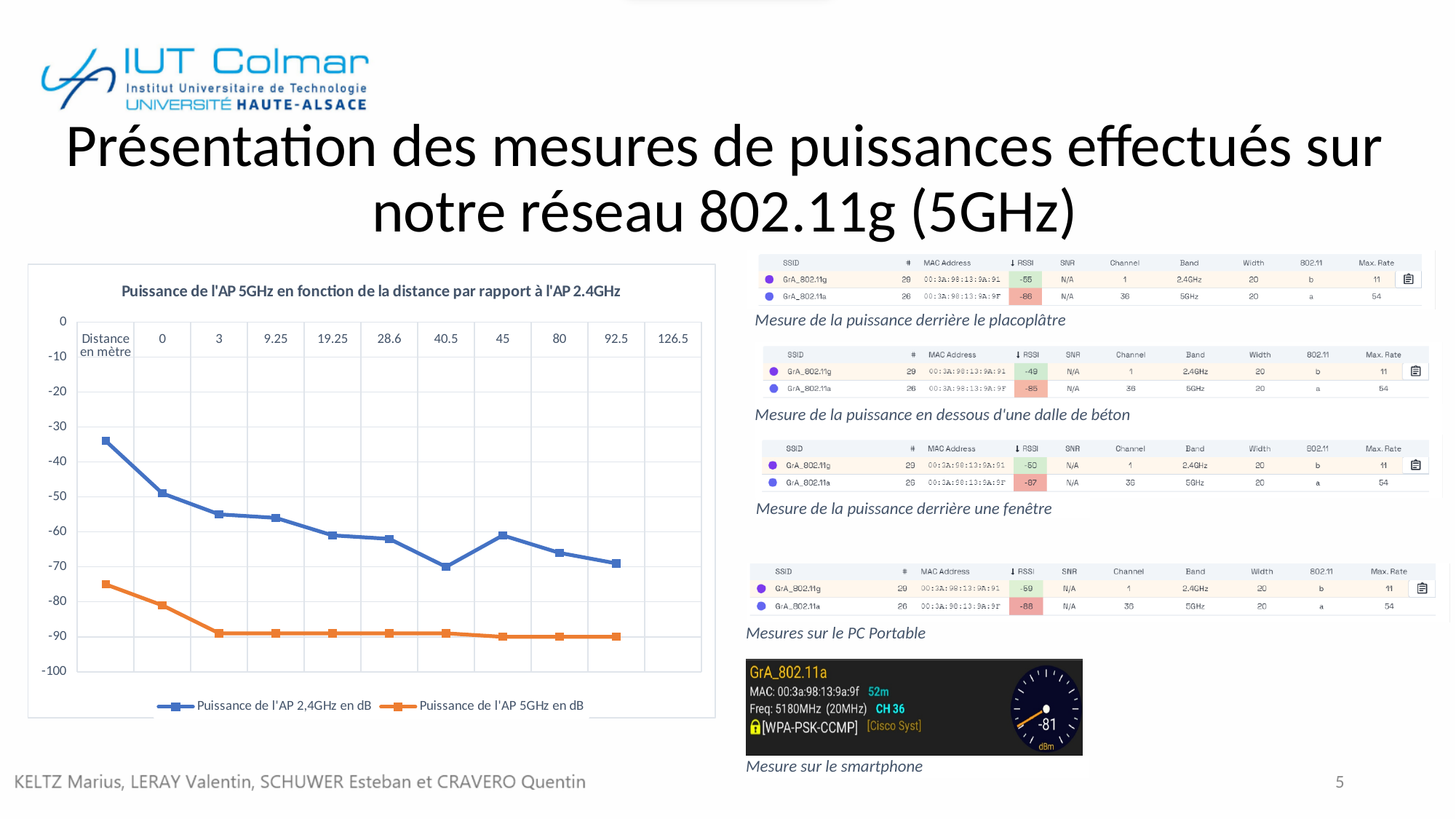
How many data points does each series in the chart have? 10 Is the leftmost value of the 'Puissance de l'AP 2,4GHz en dB' series greater or less than -40? greater What kind of chart is shown on the left of the slide? line chart How many series does the legend of the chart list? 2 Is the leftmost value of the 'Puissance de l'AP 5GHz en dB' series greater or less than -70? less Does the 'Puissance de l'AP 2,4GHz en dB' series generally rise or fall from left to right along the x axis? fall Which series reaches the lowest value on the chart? Puissance de l'AP 5GHz en dB What is the title of the chart? Puissance de l'AP 5GHz en fonction de la distance par rapport à l'AP 2.4GHz Which colour is used for the series 'Puissance de l'AP 5GHz en dB'? orange Is the rightmost value of the 'Puissance de l'AP 5GHz en dB' series greater or less than -80? less Which series has the higher values across the chart, 'Puissance de l'AP 2,4GHz en dB' or 'Puissance de l'AP 5GHz en dB'? Puissance de l'AP 2,4GHz en dB